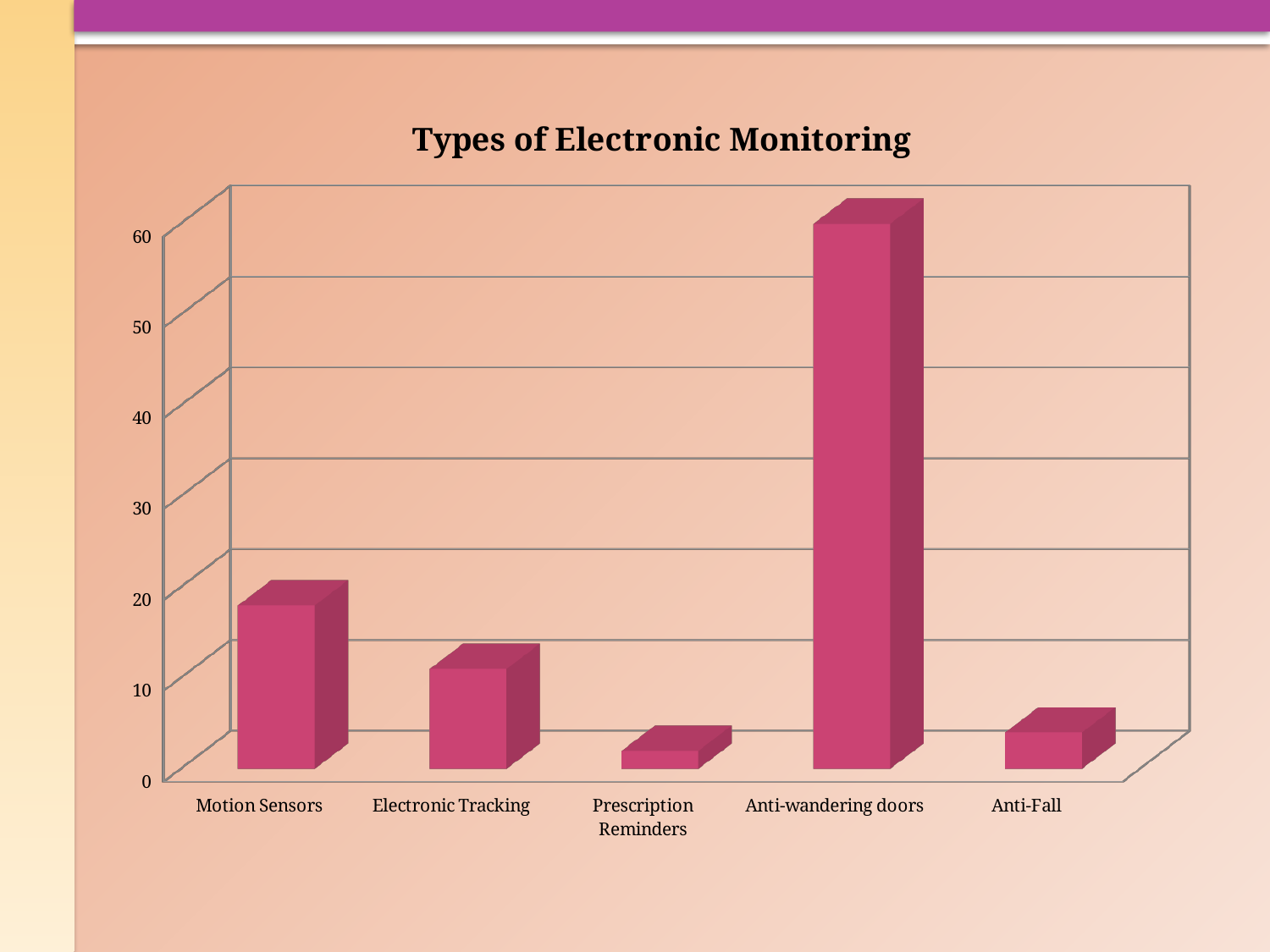
How many categories are shown on the x axis of the chart? 5 What is the title of the chart? Types of Electronic Monitoring Is the value for Anti-wandering doors greater or less than 50? greater Is the value for Anti-Fall greater or less than 10? less What is the highest value shown on the vertical axis? 60 Which is larger, the value for Motion Sensors or the value for Electronic Tracking? Motion Sensors What type of chart is shown on the slide? bar chart Is the value for Prescription Reminders greater or less than 10? less Which category has the highest value? Anti-wandering doors